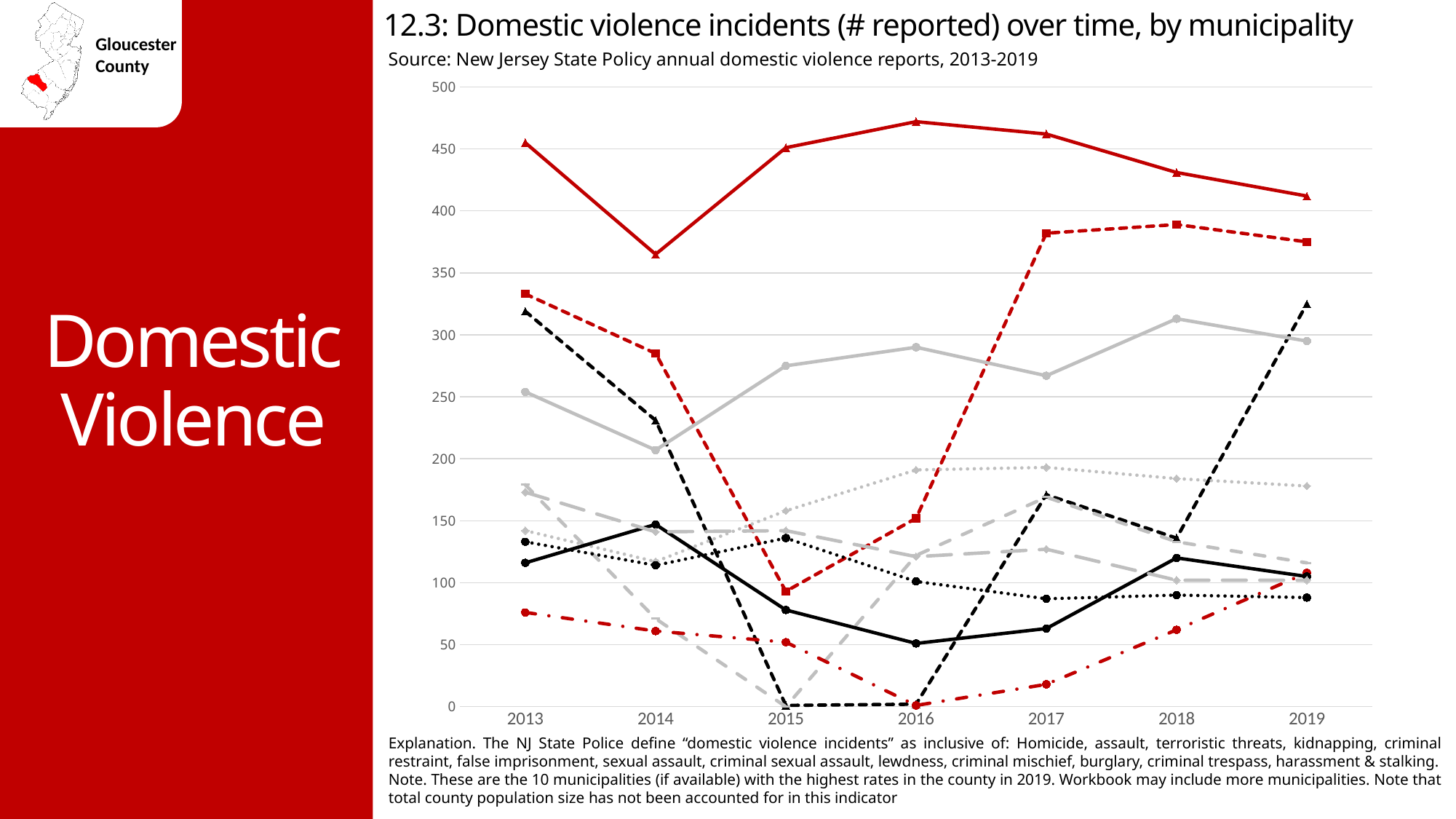
In which year does the solid red line with triangle markers reach its lowest point? 2014 Is the value of the dashed red line with square markers in 2015 greater or less than 150? less What is the highest value shown on the y axis? 500 Is the value of the solid red line with triangle markers in 2014 greater or less than 400? less Is the value of the black dashed line with triangle markers in 2019 greater or less than 300? greater What is the title of the chart? 12.3: Domestic violence incidents (# reported) over time, by municipality In which year does the solid red line with triangle markers reach its highest point? 2016 How many years are plotted along the x axis? 7 What kind of chart is shown on the slide? line chart Does the solid red line with triangle markers rise or fall from 2016 to 2019? fall